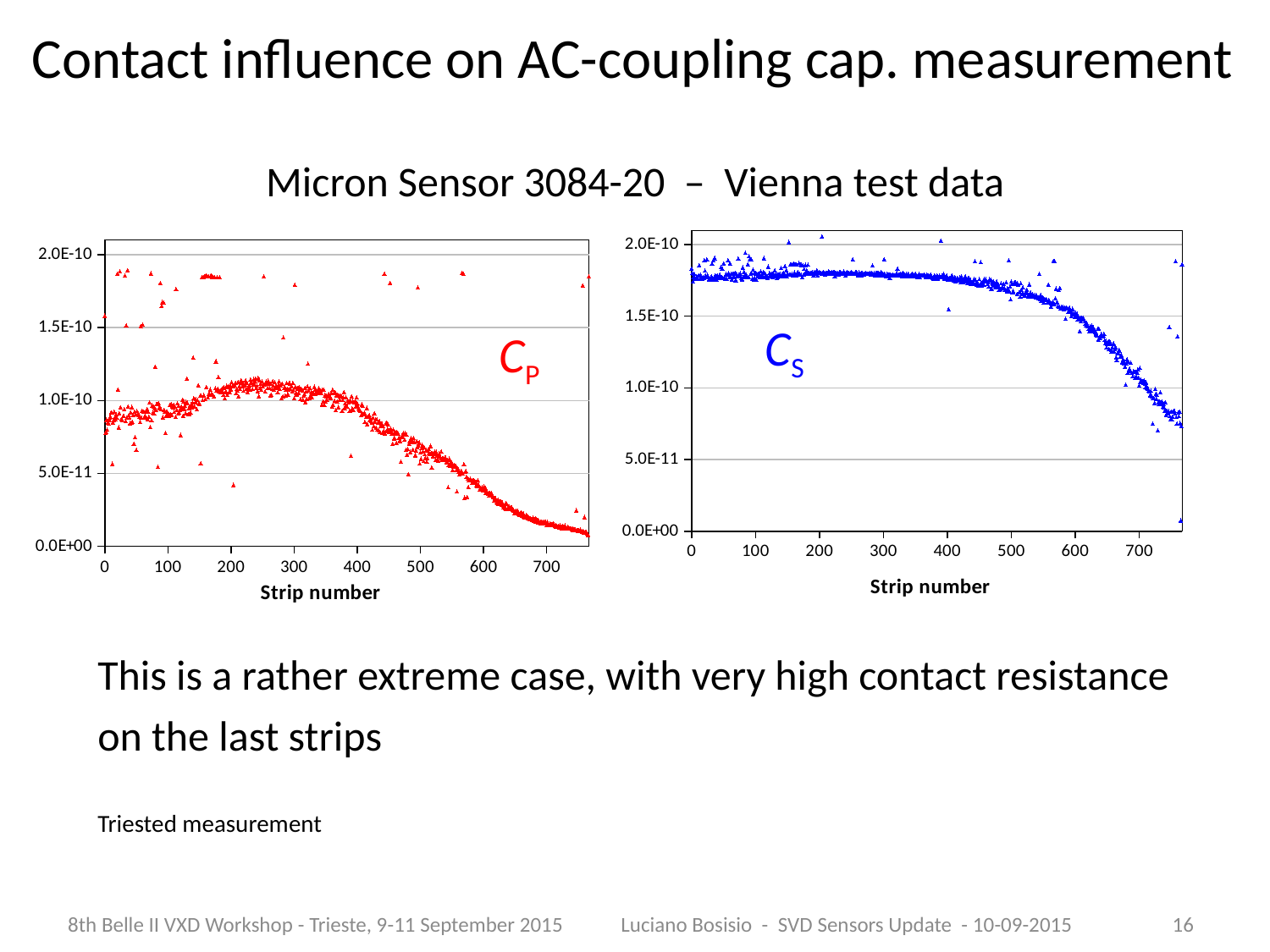
What is the x-axis title of both charts? Strip number What kind of chart is the right chart labelled C_S? scatter chart What colour are the data markers in the left chart (C_P)? red In the right chart (C_S), is the value at strip number 750 greater or less than 1.0E-10? less In the right chart (C_S), which is larger: the value at strip number 200 or the value at strip number 700? strip number 200 What kind of chart is the left chart labelled C_P? scatter chart In the right chart (C_S), is the value at strip number 300 greater or less than 1.5E-10? greater In the left chart (C_P), which is larger: the value at strip number 100 or the value at strip number 700? strip number 100 In the left chart (C_P), is the value at strip number 700 greater or less than 5.0E-11? less In the left chart (C_P), do the values rise or fall as the strip number increases from 400 to 700? fall In the right chart (C_S), do the values rise or fall as the strip number increases from 600 to 750? fall